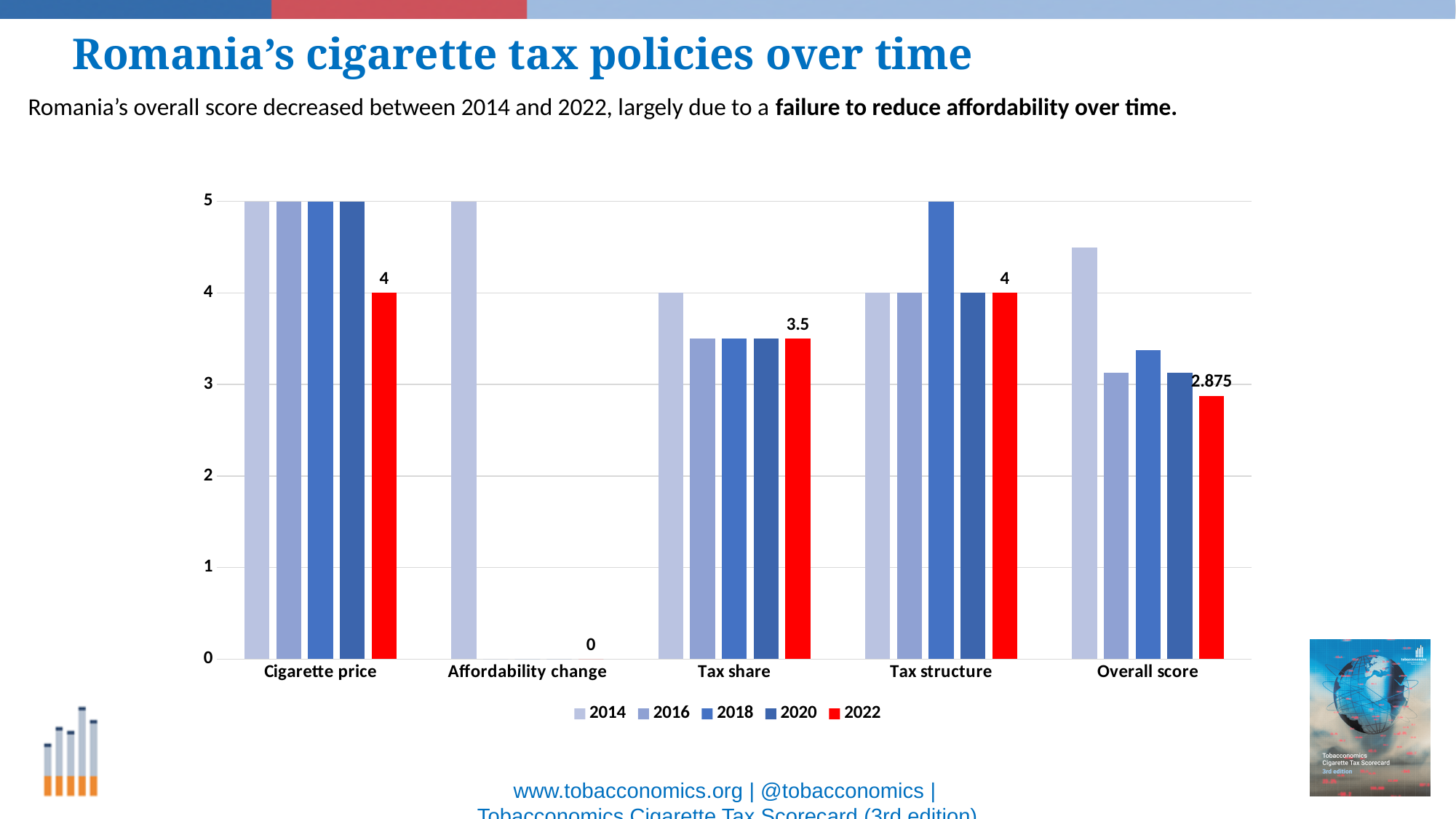
What is the 2014 value for Cigarette price? 5 What is the 2022 value for Affordability change? 0 How many categories are shown on the x axis? 5 What is the difference between the 2014 and 2022 values for Cigarette price? 1 Among the 2022 bars, which category has the lowest value? Affordability change For Tax structure, which is larger: the 2018 value or the 2020 value? 2018 What is the 2018 value for Tax structure? 5 What is the 2022 value for Tax share? 3.5 What kind of chart is shown on the slide? bar chart How many series does the legend list? 5 What is the 2022 value for Overall score? 2.875 Is the 2014 value for Overall score greater or less than 4? greater